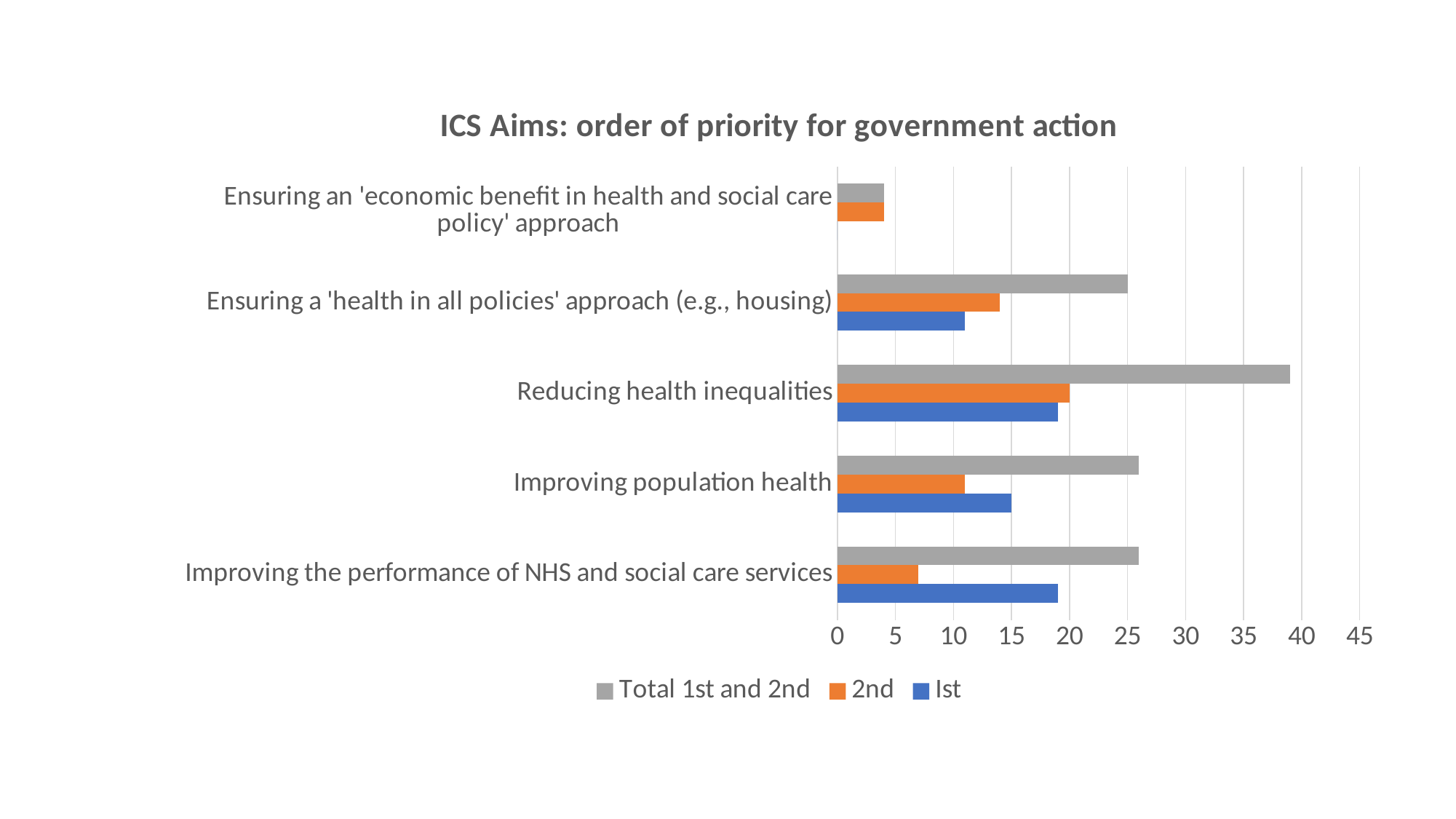
What is the title of the chart? ICS Aims: order of priority for government action Which is larger for Ensuring a 'health in all policies' approach: the '2nd' value or the 'Ist' value? 2nd Which colour represents the 'Total 1st and 2nd' series? grey Which category has the highest 'Total 1st and 2nd' value? Reducing health inequalities Which category has the lowest 'Total 1st and 2nd' value? Ensuring an 'economic benefit in health and social care policy' approach Which is larger for Improving population health: the '2nd' value or the 'Ist' value? Ist How many series does the legend list? 3 How many categories (ICS aims) are shown on the chart? 5 Is the 'Ist' value for Ensuring a 'health in all policies' approach greater or less than 15? less Is the '2nd' value for Improving the performance of NHS and social care services greater or less than 10? less Is the 'Total 1st and 2nd' value for Reducing health inequalities greater or less than 35? greater What kind of chart is shown on the slide? bar chart